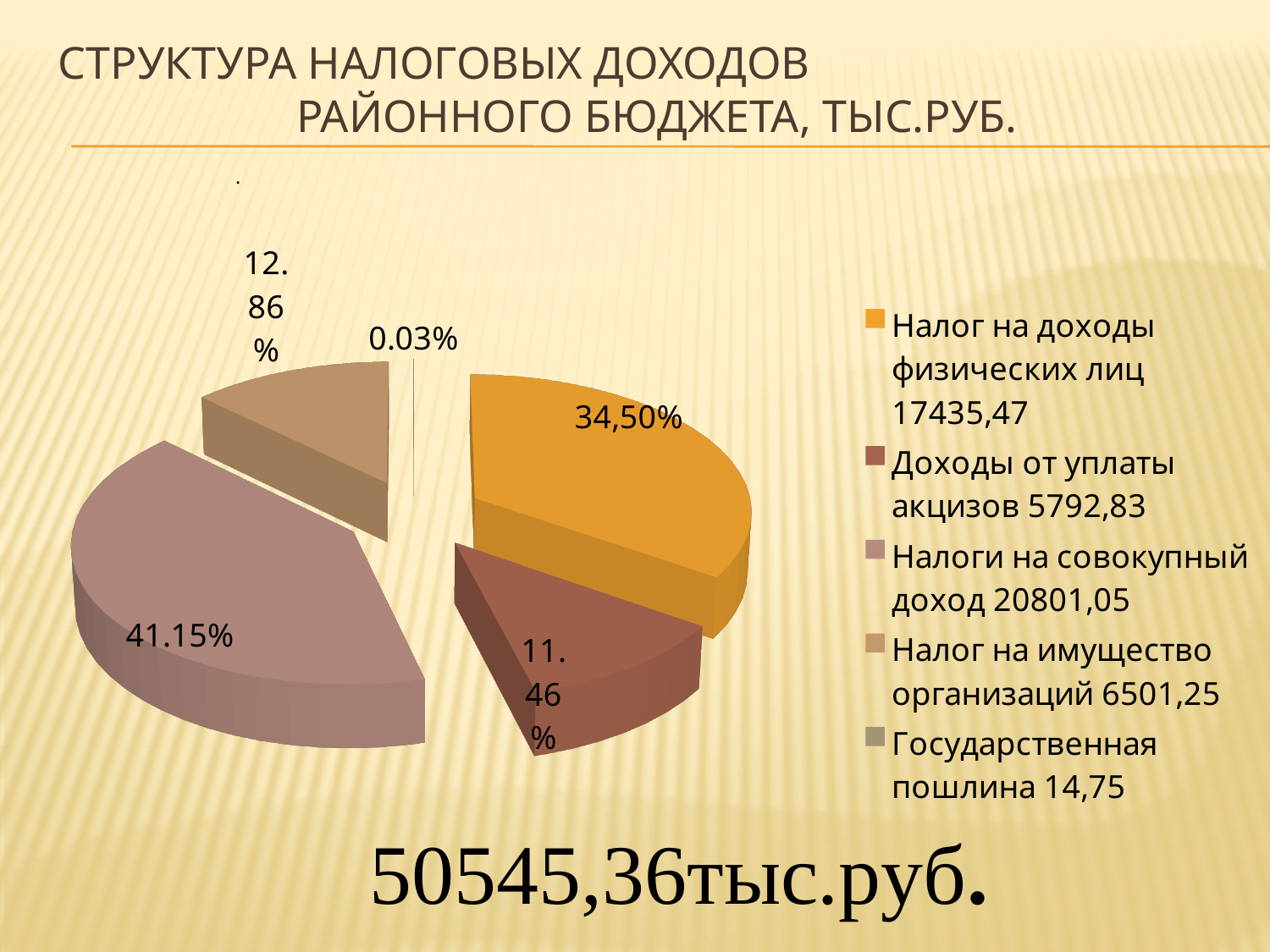
Which category has the smallest slice of the pie? Государственная пошлина What type of chart is shown on the slide? pie chart What share of the pie does "Налог на доходы физических лиц" represent? 34,50% What share of the pie does "Государственная пошлина" represent? 0.03% What total amount in тыс.руб. is printed below the chart? 50545,36 What share of the pie does "Налоги на совокупный доход" represent? 41.15% How many categories does the pie chart show? 5 Which is larger: the slice for "Налог на имущество организаций" or the slice for "Доходы от уплаты акцизов"? Налог на имущество организаций According to the legend, what is the value (тыс.руб.) for "Доходы от уплаты акцизов"? 5792,83 Which category has the largest slice of the pie? Налоги на совокупный доход